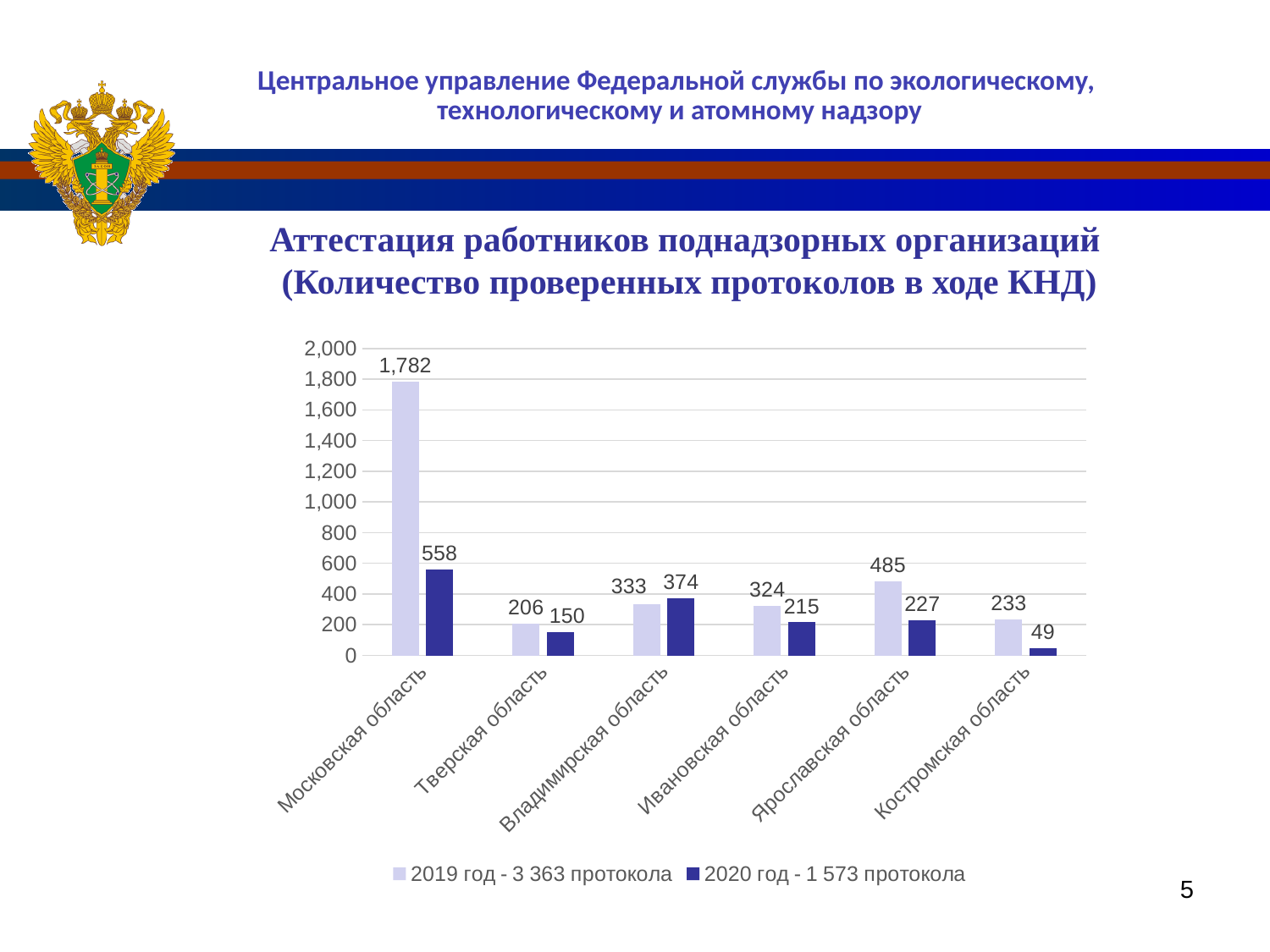
What total number of protocols does the legend give for 2020? 1 573 Which region has the highest value in the 2020 series? Московская область How many regions are shown on the x axis? 6 How many series does the legend list? 2 What is the value for Московская область in the 2019 series? 1,782 Which is larger for Владимирская область: the 2019 value or the 2020 value? 2020 value Is the 2019 value for Ивановская область greater or less than 400? less What is the difference between the 2019 and 2020 values for Московская область? 1,224 What is the value for Костромская область in the 2020 series? 49 Which region has the lowest value in the 2019 series? Тверская область What kind of chart is shown on the slide? bar chart What is the value for Ярославская область in the 2019 series? 485